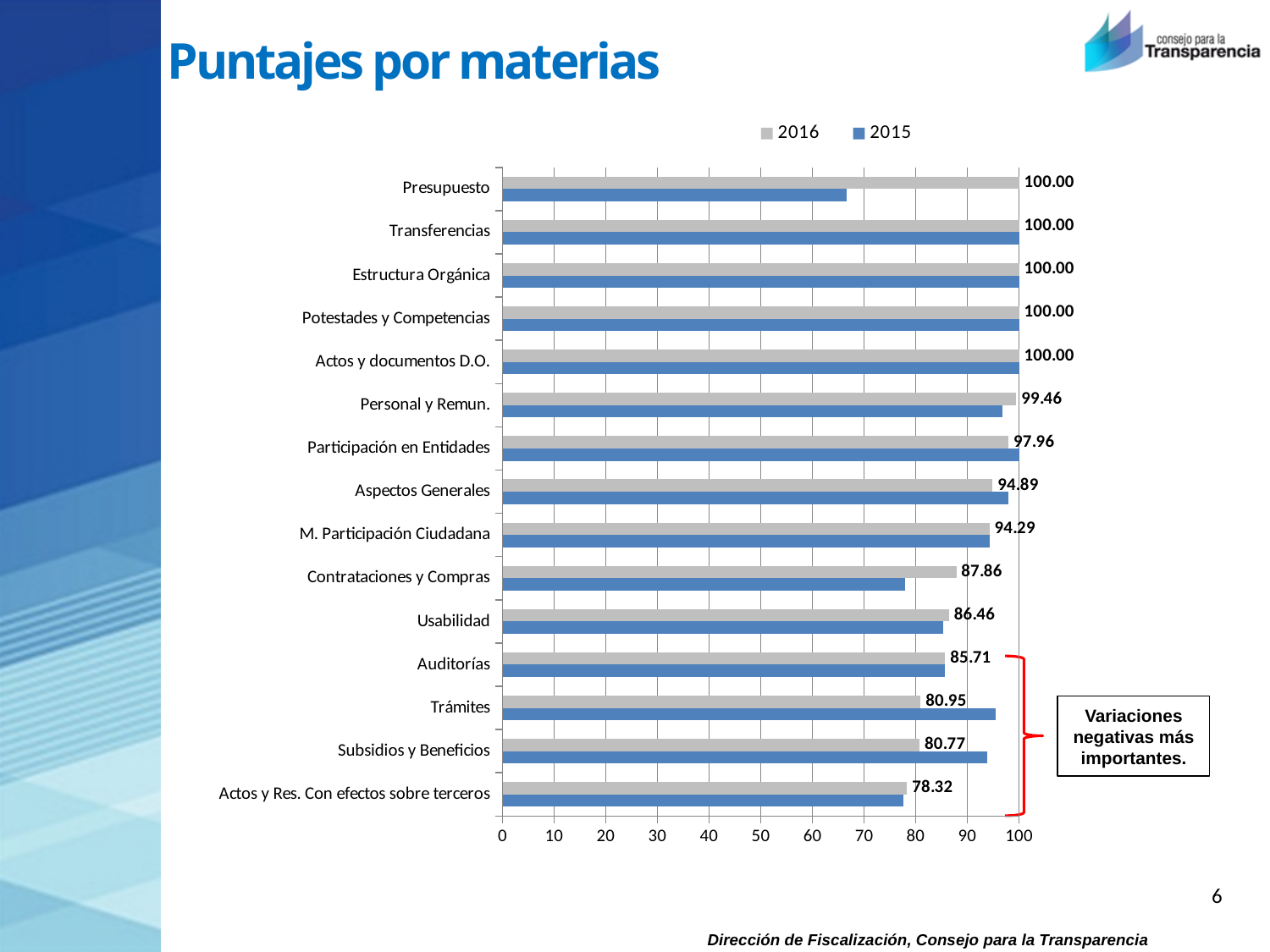
For Presupuesto, which series has the larger value, 2016 or 2015? 2016 How many series does the legend list? 2 What is the title of the slide containing the chart? Puntajes por materias For Trámites, which series has the larger value, 2016 or 2015? 2015 What is the 2016 value for Contrataciones y Compras? 87.86 What is the 2016 value for Usabilidad? 86.46 What is the difference between the 2016 values for Auditorías and Trámites? 4.76 Is the 2015 value for Presupuesto greater or less than 70? less How many categories are shown on the chart? 15 What kind of chart is shown on the slide? bar chart Which category has the lowest 2016 value? Actos y Res. Con efectos sobre terceros What is the 2016 value for Trámites? 80.95